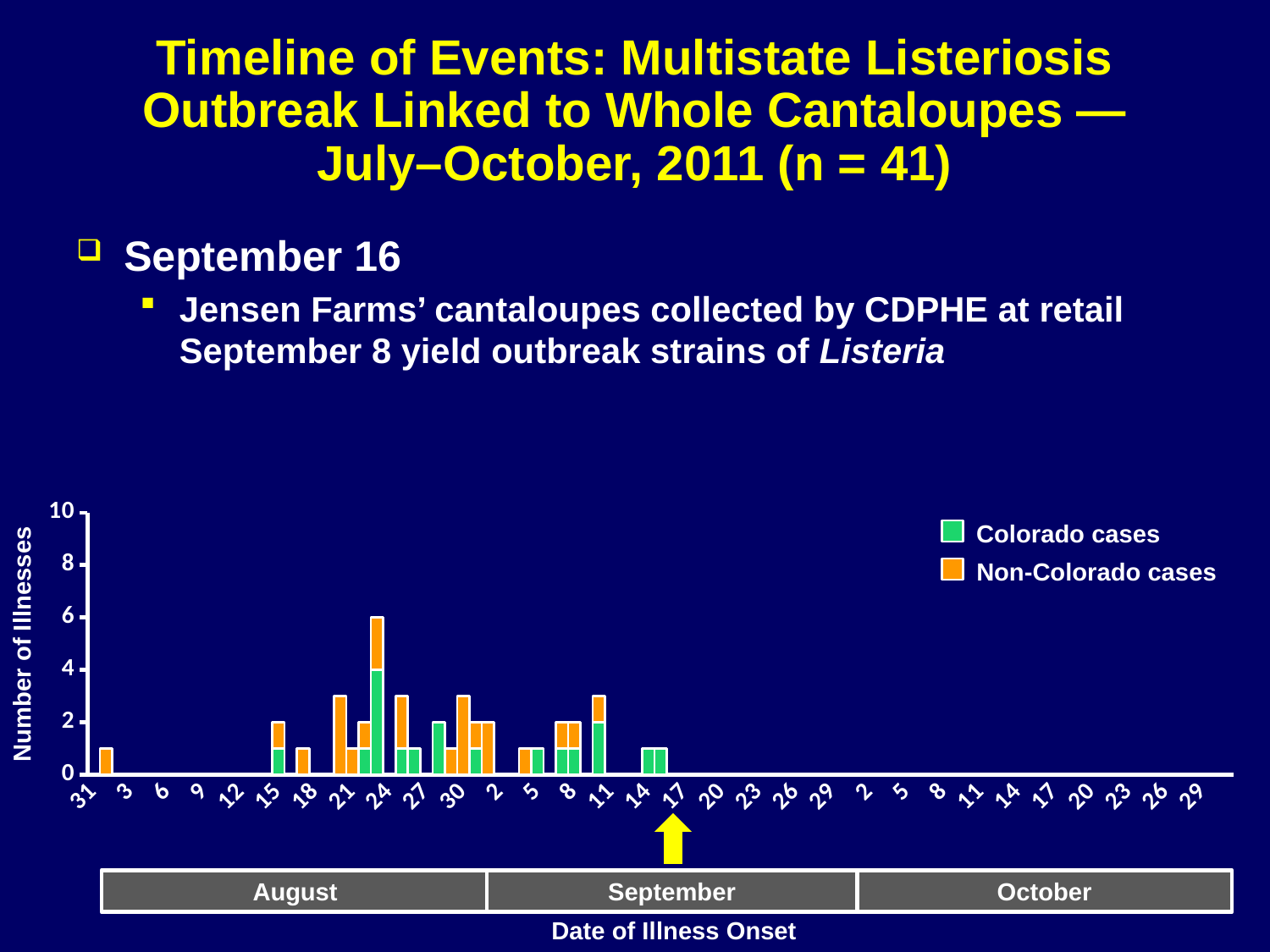
How many series does the chart legend list? 2 Do the number of illnesses generally rise or fall from late August through October? fall What is the label on the vertical axis of the chart? Number of Illnesses What kind of chart is shown on the slide? Stacked bar chart What are the two series named in the chart legend? Colorado cases and Non-Colorado cases Which month on the x axis has no illness onset bars at all? October How many months are shown along the x axis of the chart? 3 What is the highest value shown on the vertical axis? 10